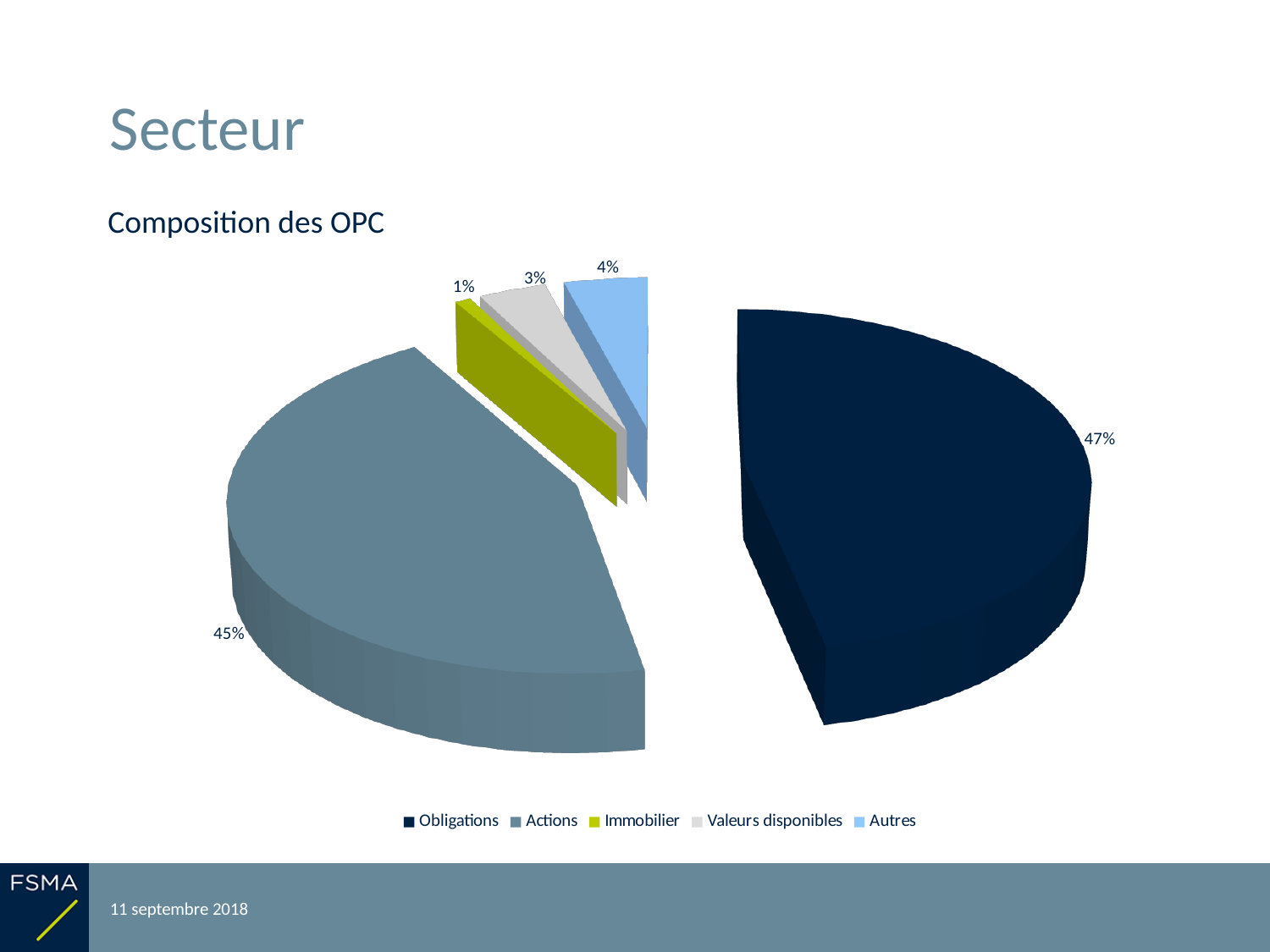
How many categories does the pie chart show? 5 What is the difference in percentage points between Obligations and Actions? 2 What kind of chart is shown on the slide? Pie chart What share of the pie does Immobilier represent? 1% What share of the pie does Valeurs disponibles represent? 3% Which category has the smallest slice of the pie? Immobilier What share of the pie does Actions represent? 45% What is the title of the chart? Composition des OPC Which is larger, the share for Autres or the share for Valeurs disponibles? Autres Which category has the largest slice of the pie? Obligations